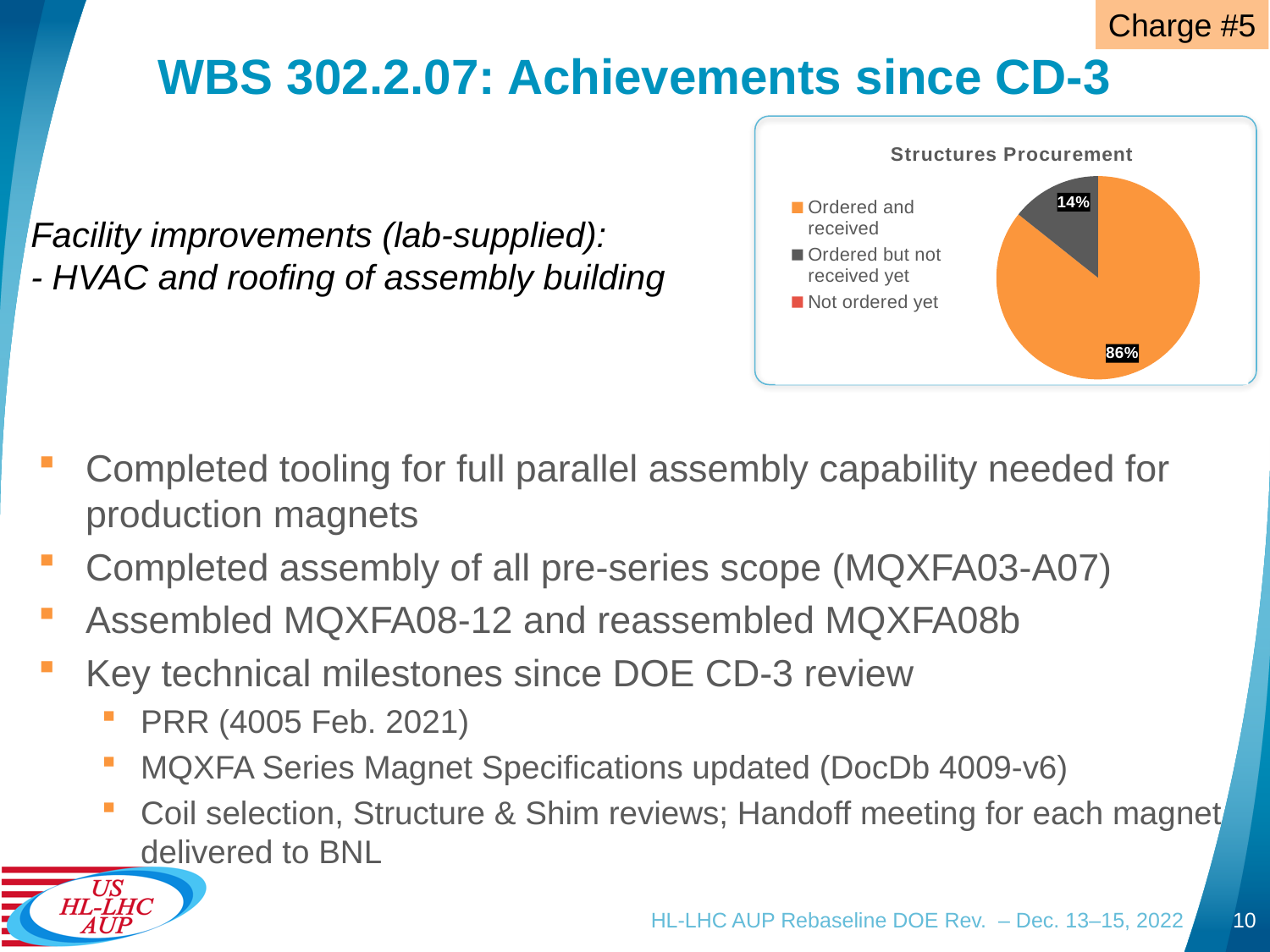
What is the title of the chart on the slide? Structures Procurement What kind of chart is shown on the slide? pie chart Which category has the largest slice in the Structures Procurement pie chart? Ordered and received Which legend category has the smallest visible slice in the Structures Procurement pie chart? Ordered but not received yet Which colour represents 'Ordered and received' in the Structures Procurement chart? orange Is the share for 'Ordered and received' greater or less than 50%? greater How many entries does the legend of the Structures Procurement chart list? 3 Which is larger in the Structures Procurement chart: 'Ordered and received' or 'Ordered but not received yet'? Ordered and received What share of the Structures Procurement pie is 'Ordered but not received yet'? 14% What is the difference in percentage points between the 'Ordered and received' and 'Ordered but not received yet' slices? 72 What share of the Structures Procurement pie is 'Ordered and received'? 86%